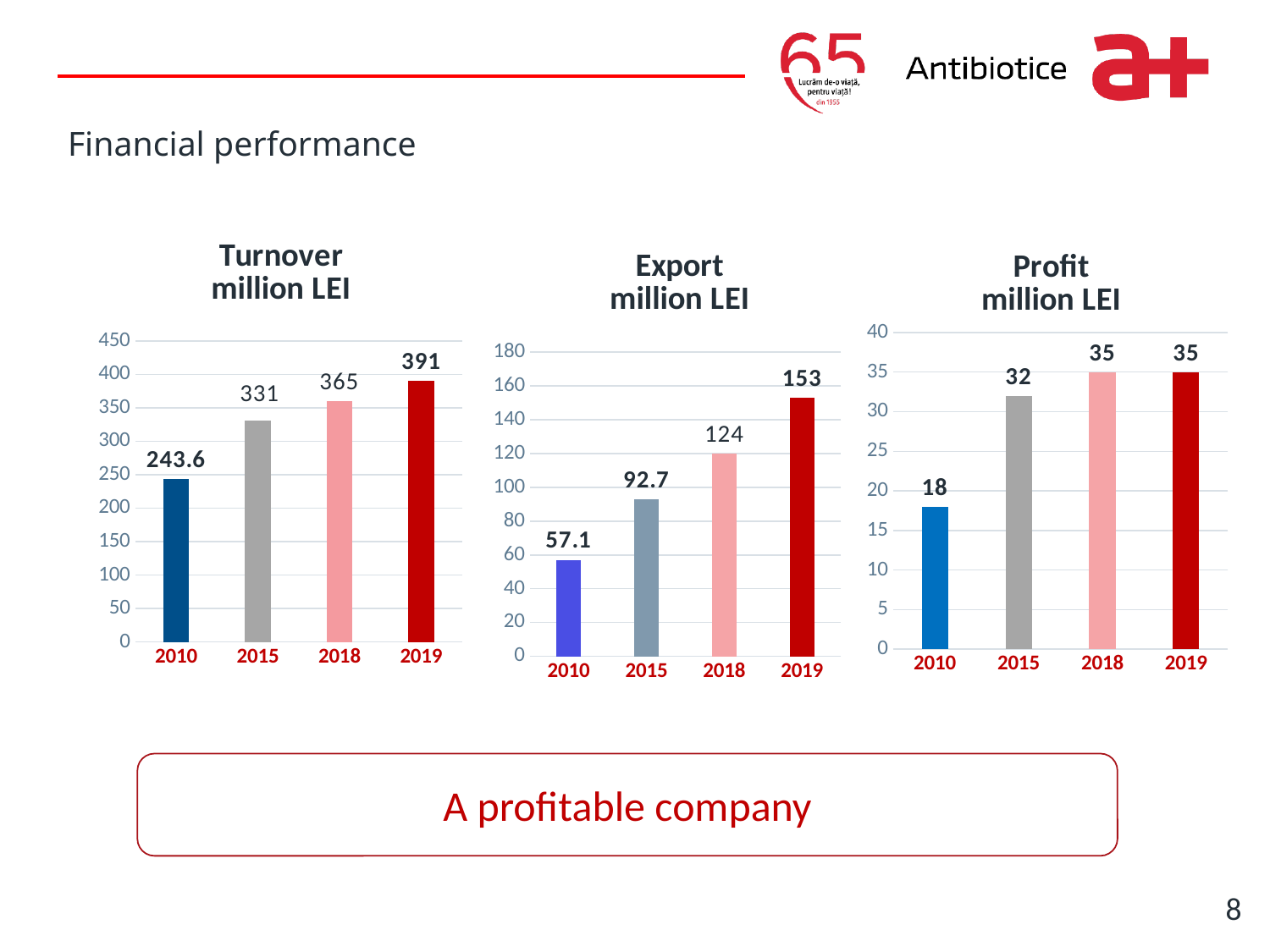
In the Export chart, which year has the highest value? 2019 In the Turnover chart, which year has the lowest value? 2010 In the Export chart, is the value for 2018 greater or less than 100? greater In the Profit chart, what is the value for 2015? 32 In the Turnover chart, what is the difference between the 2019 and 2015 values? 60 How many years are shown on the x axis of the Profit chart? 4 What kind of chart is the Turnover chart? bar chart In the Export chart, do the values rise or fall from 2010 to 2019? rise In the Export chart, what is the difference between the 2018 and 2015 values? 31.3 In the Profit chart, which is larger, the value for 2010 or the value for 2015? 2015 In the Export chart, what is the value for 2010? 57.1 In the Turnover chart, what is the value for 2019? 391